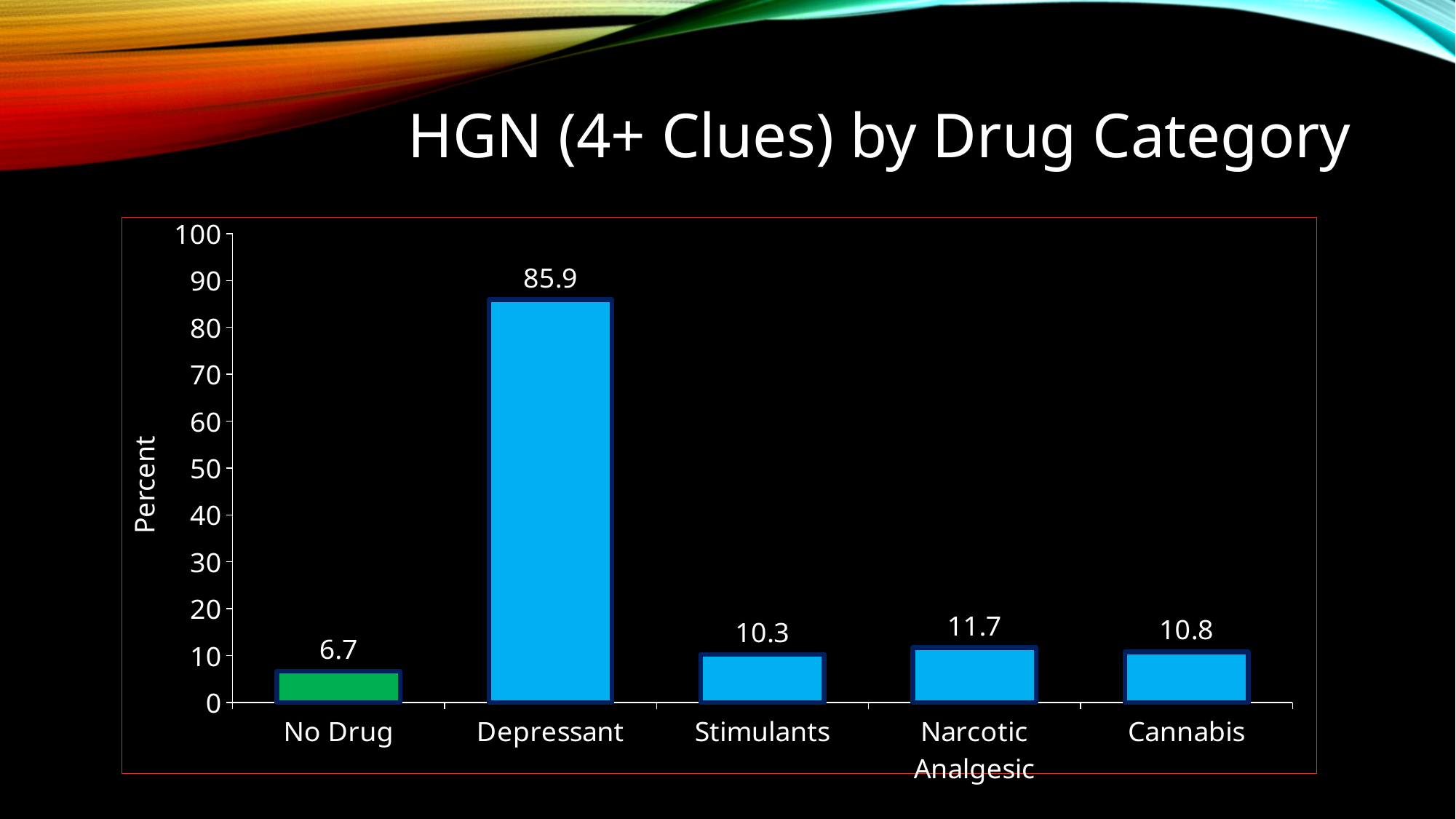
Which is larger, the value for Narcotic Analgesic or the value for Cannabis? Narcotic Analgesic Which drug category has the highest value? Depressant What is the value for No Drug? 6.7 How many drug categories are shown on the x axis? 5 What is the value for Narcotic Analgesic? 11.7 What is the label on the vertical axis? Percent What is the value for Depressant? 85.9 What kind of chart is shown on the slide? bar chart Is the value for Depressant greater or less than 80? greater Which drug category has the lowest value? No Drug What is the value for Cannabis? 10.8 What is the difference between the values for Depressant and Stimulants? 75.6